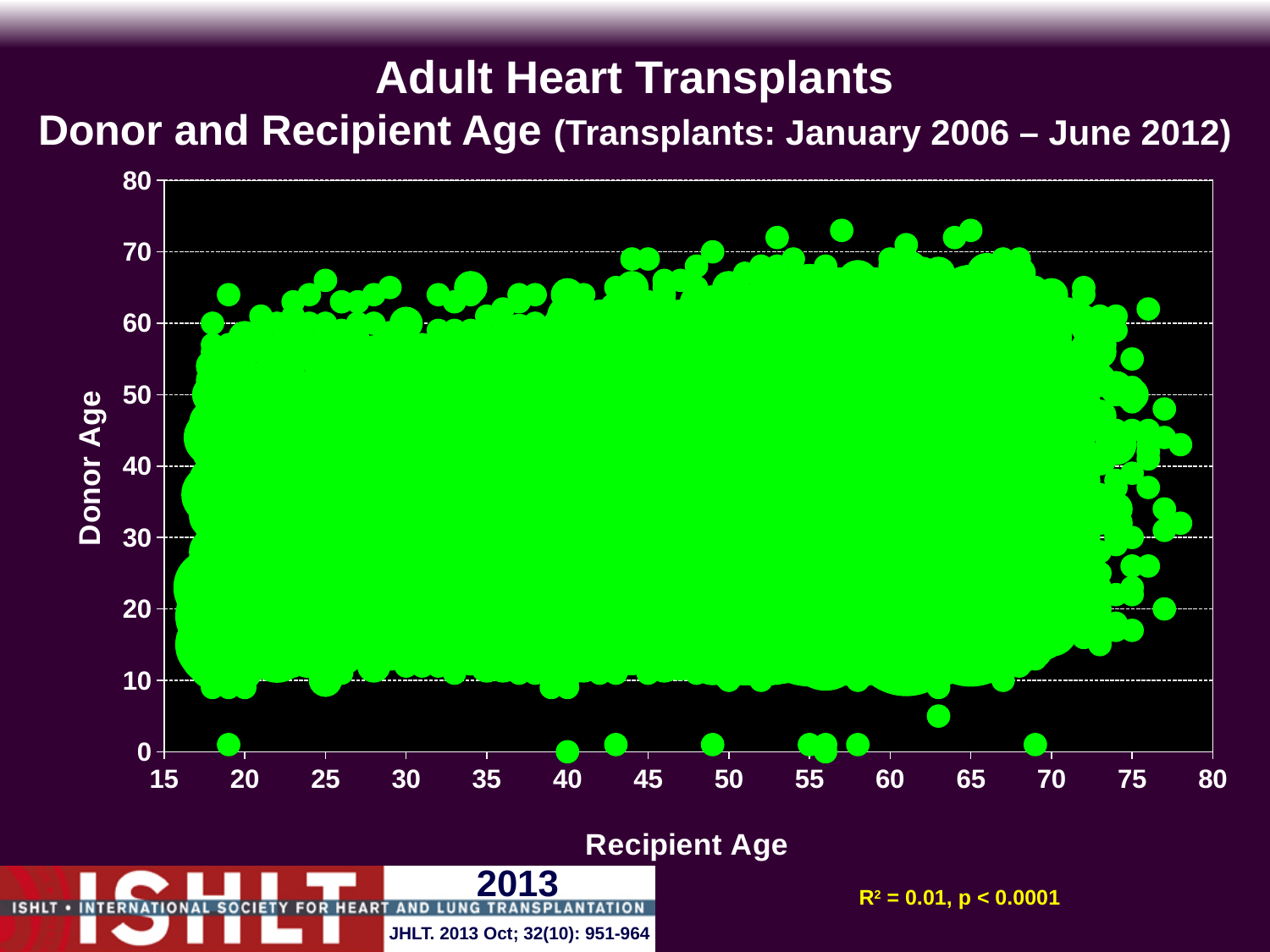
What variable is plotted on the x axis of the chart? Recipient Age What is the R² value reported on the slide? R² = 0.01 What variable is plotted on the y axis of the chart? Donor Age What kind of chart is shown on the slide? scatter plot What p-value is reported on the slide? p < 0.0001